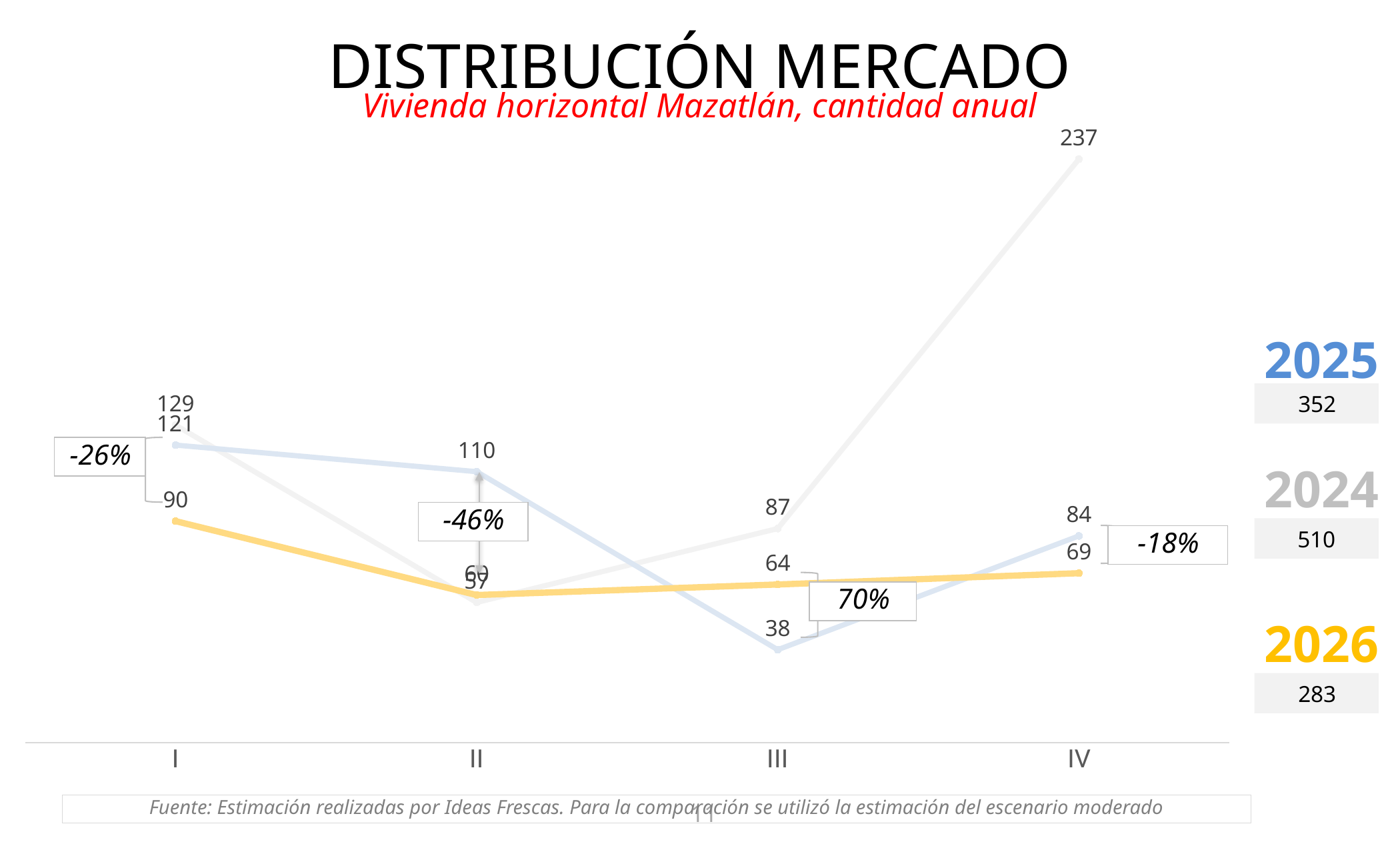
What is the difference between the 2024 and 2025 values in quarter IV? 153 How many series (years) are plotted on the chart? 3 How many quarters are shown on the x axis? 4 What is the value for 2025 in quarter II? 110 In which quarter does the 2025 series reach its lowest value? III What annual total is shown for 2024 on the right of the chart? 510 In which quarter does the 2024 series reach its highest value? IV What is the value for 2026 in quarter I? 90 Which series has the larger value in quarter III, 2025 or 2026? 2026 What is the value for 2024 in quarter IV? 237 What is the value for 2025 in quarter III? 38 What kind of chart is shown on the slide? line chart